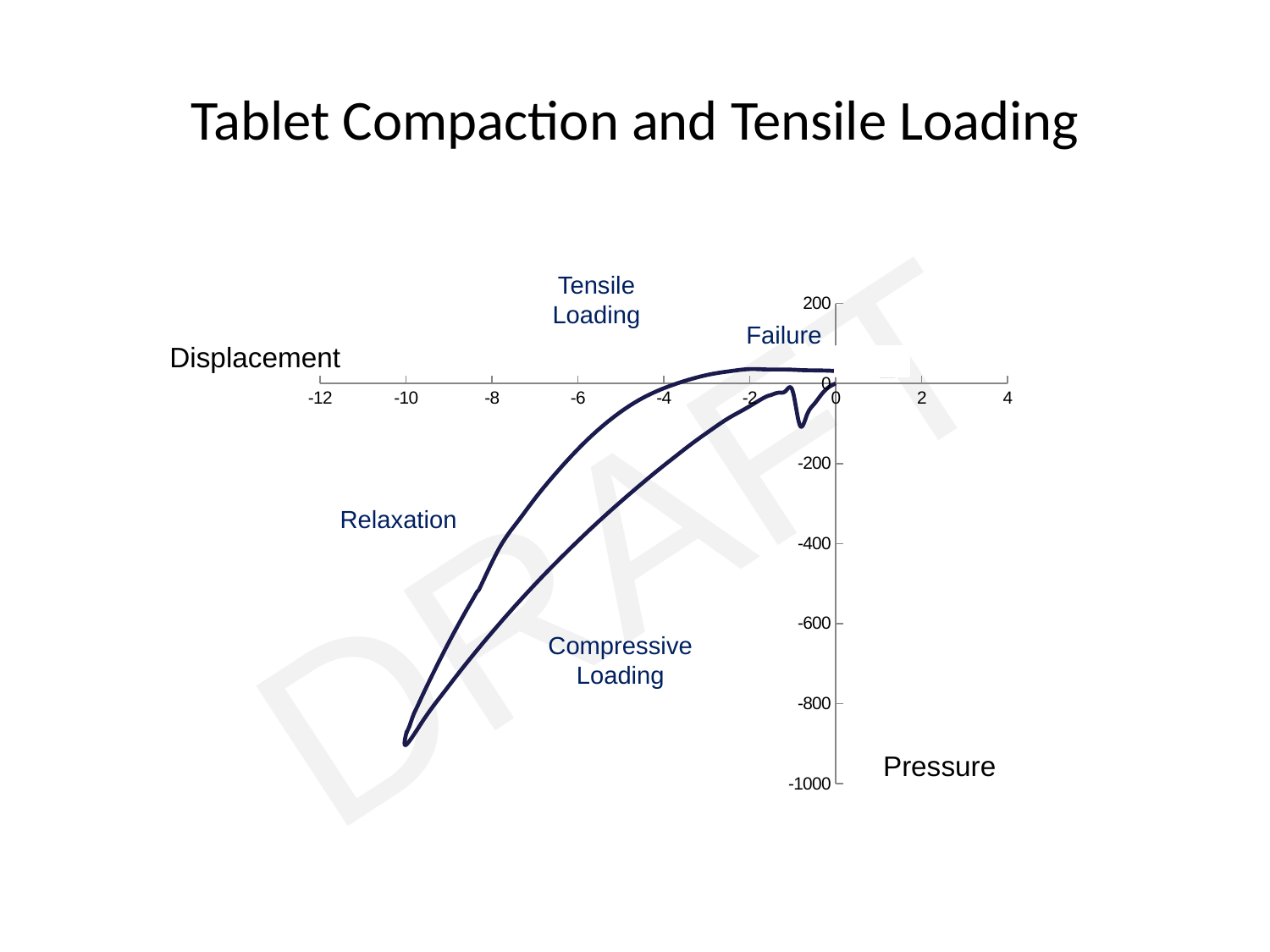
Is the highest pressure reached by the curve greater or less than 200? less At a displacement of -6, which curve shows the higher pressure, the Relaxation curve or the Compressive Loading curve? Relaxation Is the displacement at the point labelled Failure greater or less than -2? greater Is the lowest pressure reached by the curve greater or less than -800? less What kind of chart is shown on the slide? line chart Along the Compressive Loading curve, does pressure rise or fall as displacement increases from -10 toward 0? rise What is the title of the slide? Tablet Compaction and Tensile Loading What quantity is plotted on the vertical axis of the chart? Pressure